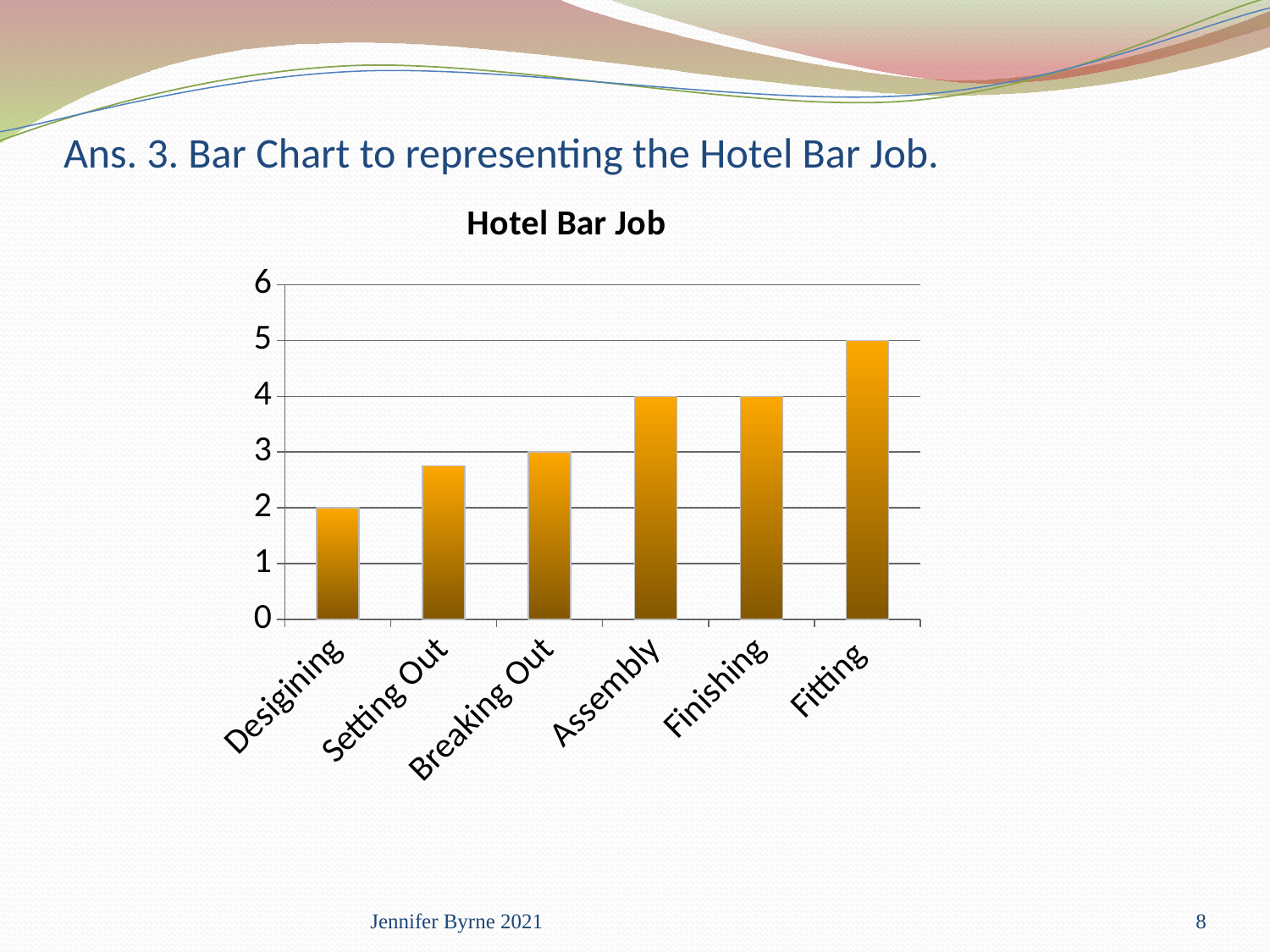
Which category has the highest bar? Fitting What is the value for Desigining? 2 What is the value for Breaking Out? 3 What is the value for Assembly? 4 What type of chart is shown on the slide? Bar chart Do the bar values generally rise or fall from left to right along the x axis? Rise What is the value for Fitting? 5 What is the difference between the values for Fitting and Desigining? 3 What is the title of the chart? Hotel Bar Job Is the value for Setting Out greater or less than 3? less Which category has the lowest bar? Desigining How many categories are shown on the x axis of the chart? 6